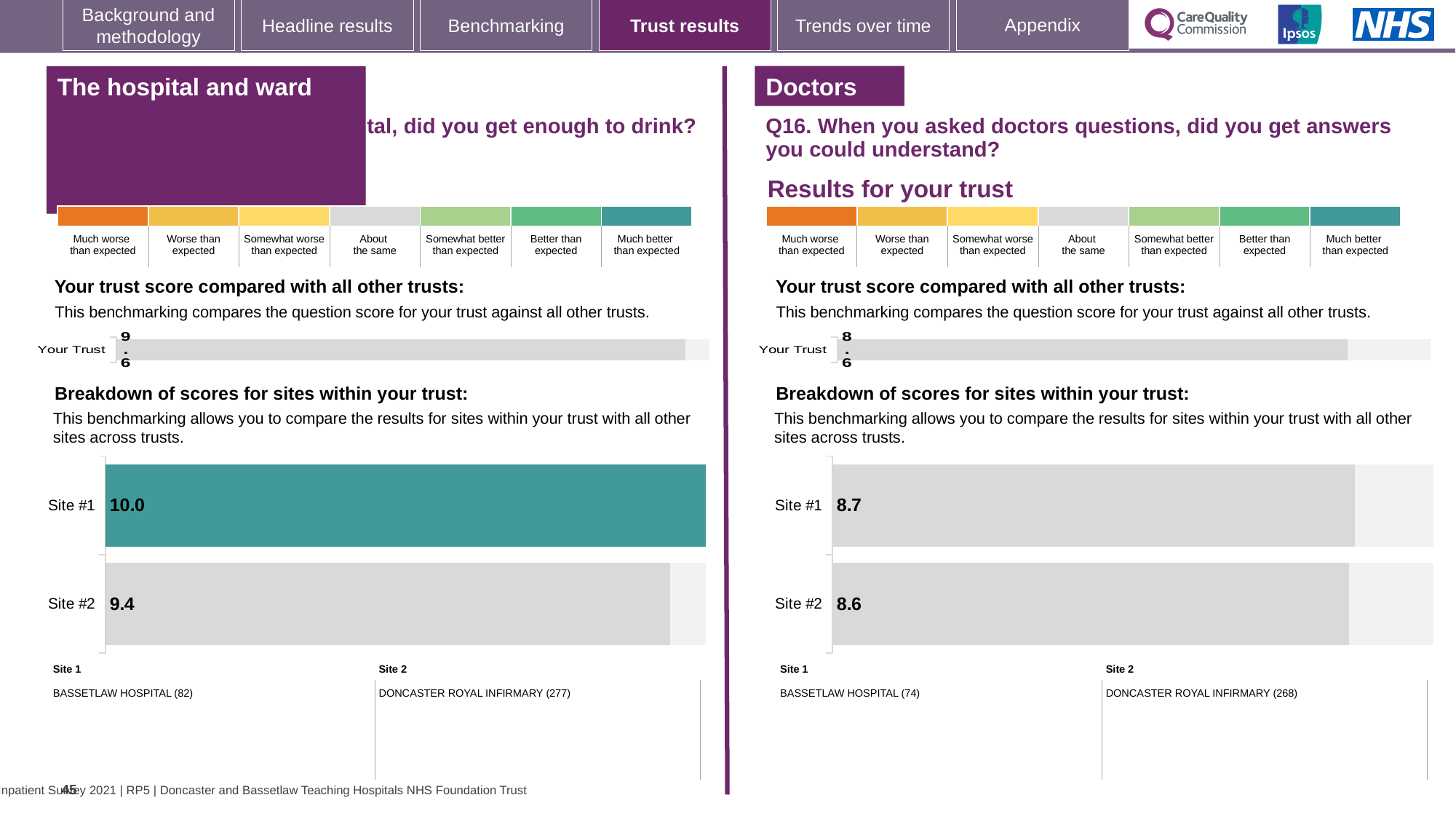
In the site breakdown chart on the left-hand side of the slide, what is the difference between the Site #1 and Site #2 scores? 0.6 In the site breakdown chart on the left-hand side of the slide, what is the value for Site #2? 9.4 In the 'Your trust score compared with all other trusts' chart on the left-hand side of the slide, what is the value for Your Trust? 9.6 How many sites are shown in the site breakdown chart on the left-hand side of the slide? 2 In the 'Your trust score compared with all other trusts' chart for Q16 on the right-hand side of the slide, what is the value for Your Trust? 8.6 In the site breakdown chart on the left-hand side of the slide, which site has the higher score? Site #1 In the site breakdown chart on the left-hand side of the slide, what is the value for Site #1? 10.0 In the site breakdown chart for Q16 on the right-hand side of the slide, what is the value for Site #1? 8.7 In the site breakdown chart on the left-hand side of the slide, which site's bar is coloured teal rather than grey? Site #1 What type of chart is the site breakdown chart for Q16 on the right-hand side of the slide? Bar chart In the site breakdown chart for Q16 on the right-hand side of the slide, what is the value for Site #2? 8.6 In the site breakdown chart for Q16 on the right-hand side of the slide, what is the difference between the Site #1 and Site #2 scores? 0.1